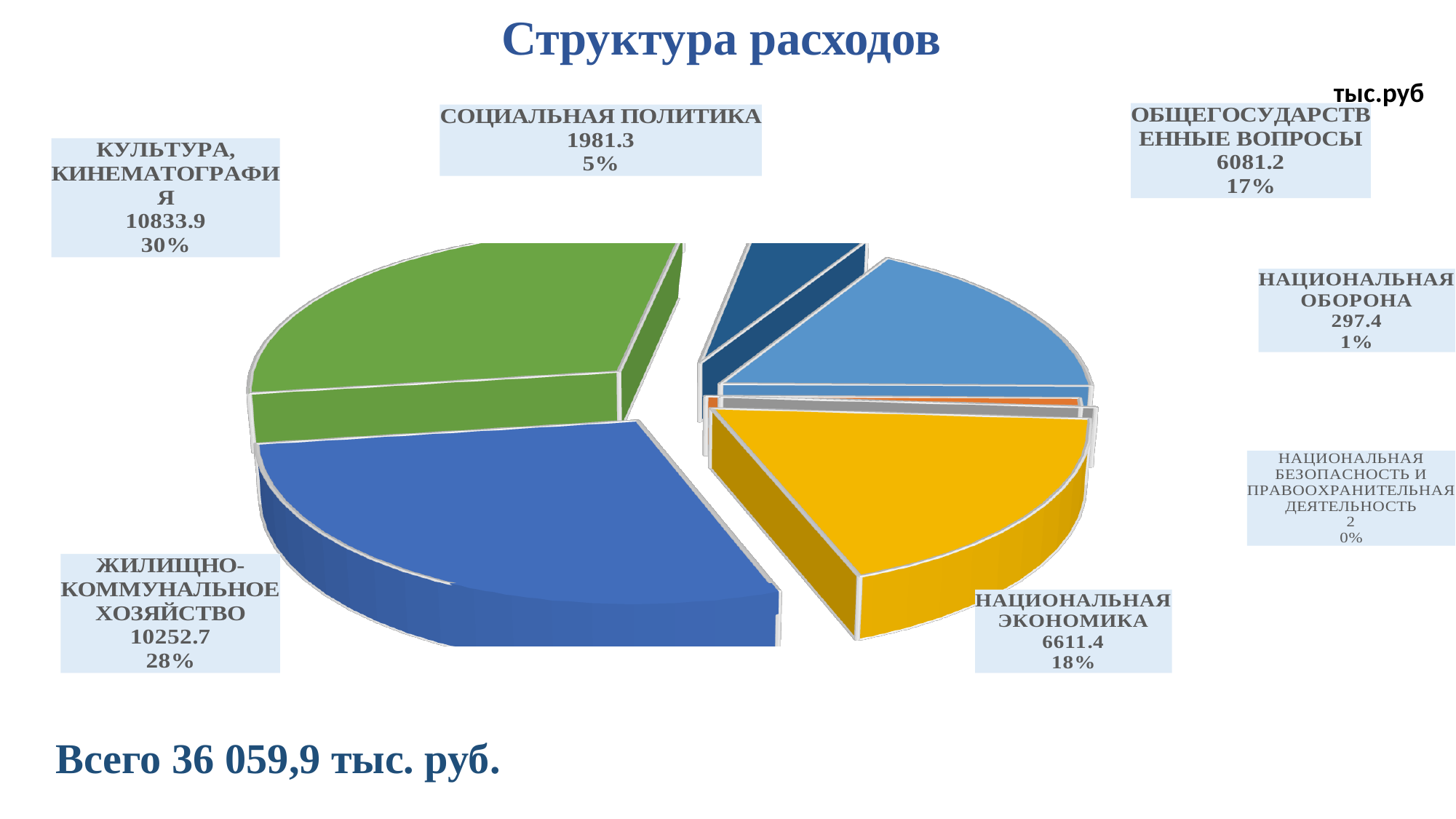
What is the difference between the values for Культура, кинематография and Жилищно-коммунальное хозяйство? 581.2 What type of chart is shown on the slide? pie chart Which category has the smallest value? Национальная безопасность и правоохранительная деятельность Which category has the largest value? Культура, кинематография How many categories does the pie chart show? 7 What share of the pie does Жилищно-коммунальное хозяйство take? 28% What share of the pie does Общегосударственные вопросы take? 17% Which is larger, Национальная экономика or Общегосударственные вопросы? Национальная экономика What is the value for Национальная оборона? 297.4 What is the title of the chart? Структура расходов What is the value for Культура, кинематография? 10833.9 What is the value for Национальная экономика? 6611.4